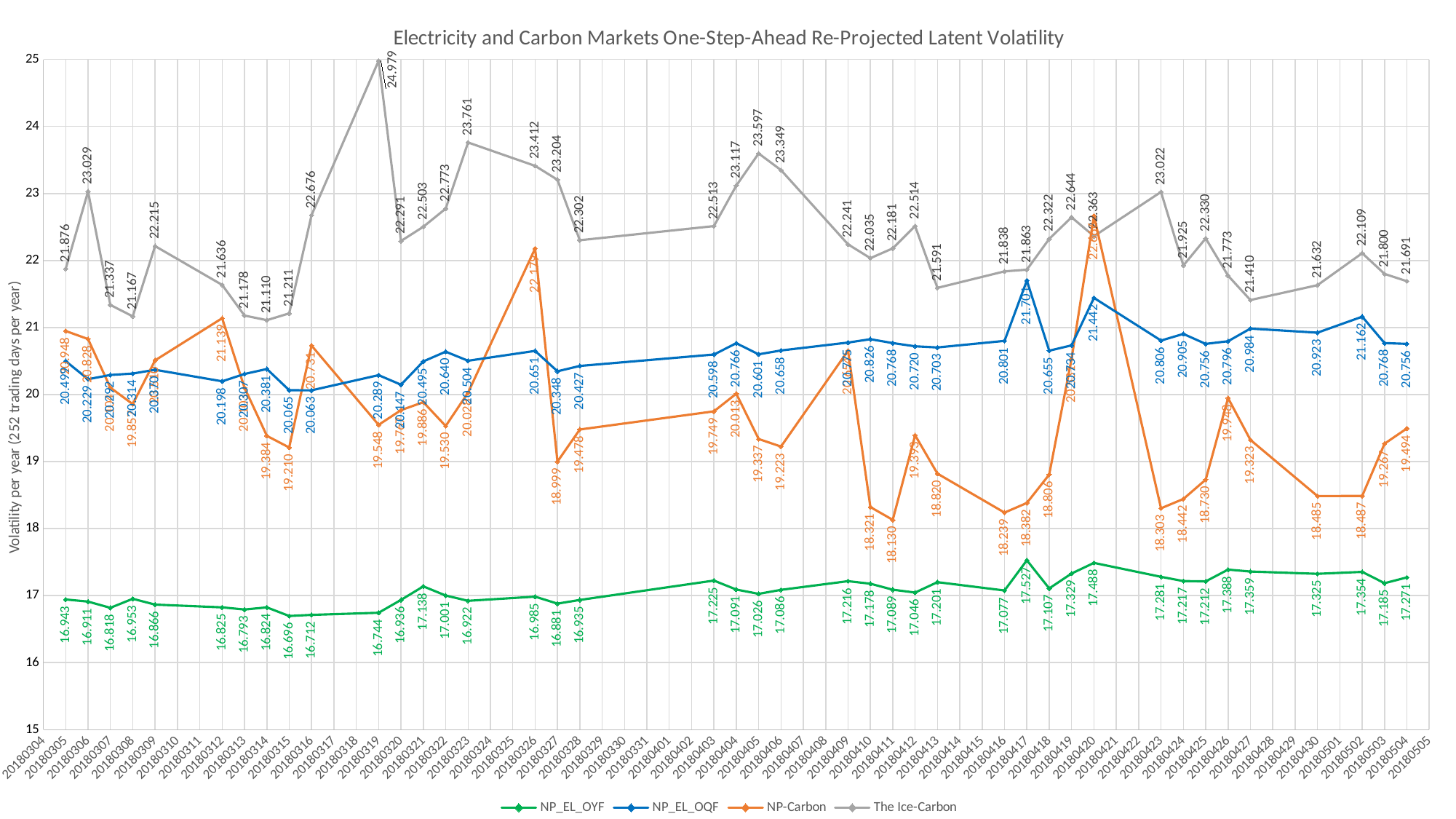
Is the value of The Ice-Carbon series at 20180319 greater or less than 24? greater At which date does The Ice-Carbon series reach its highest value? 20180319 What kind of chart is shown on the slide? line chart What is the value of The Ice-Carbon series at 20180319? 24.979 What is the value of NP-Carbon at 20180411? 18.130 What is the difference between The Ice-Carbon values at 20180306 and 20180305? 1.153 How many series does the legend list? 4 Which is larger at 20180417: NP_EL_OQF or NP_EL_OYF? NP_EL_OQF What is the value of NP_EL_OYF at 20180305? 16.943 What is the title of the chart? Electricity and Carbon Markets One-Step-Ahead Re-Projected Latent Volatility What is the value of NP_EL_OQF at 20180504? 20.756 At which date does NP_EL_OYF reach its lowest value? 20180315